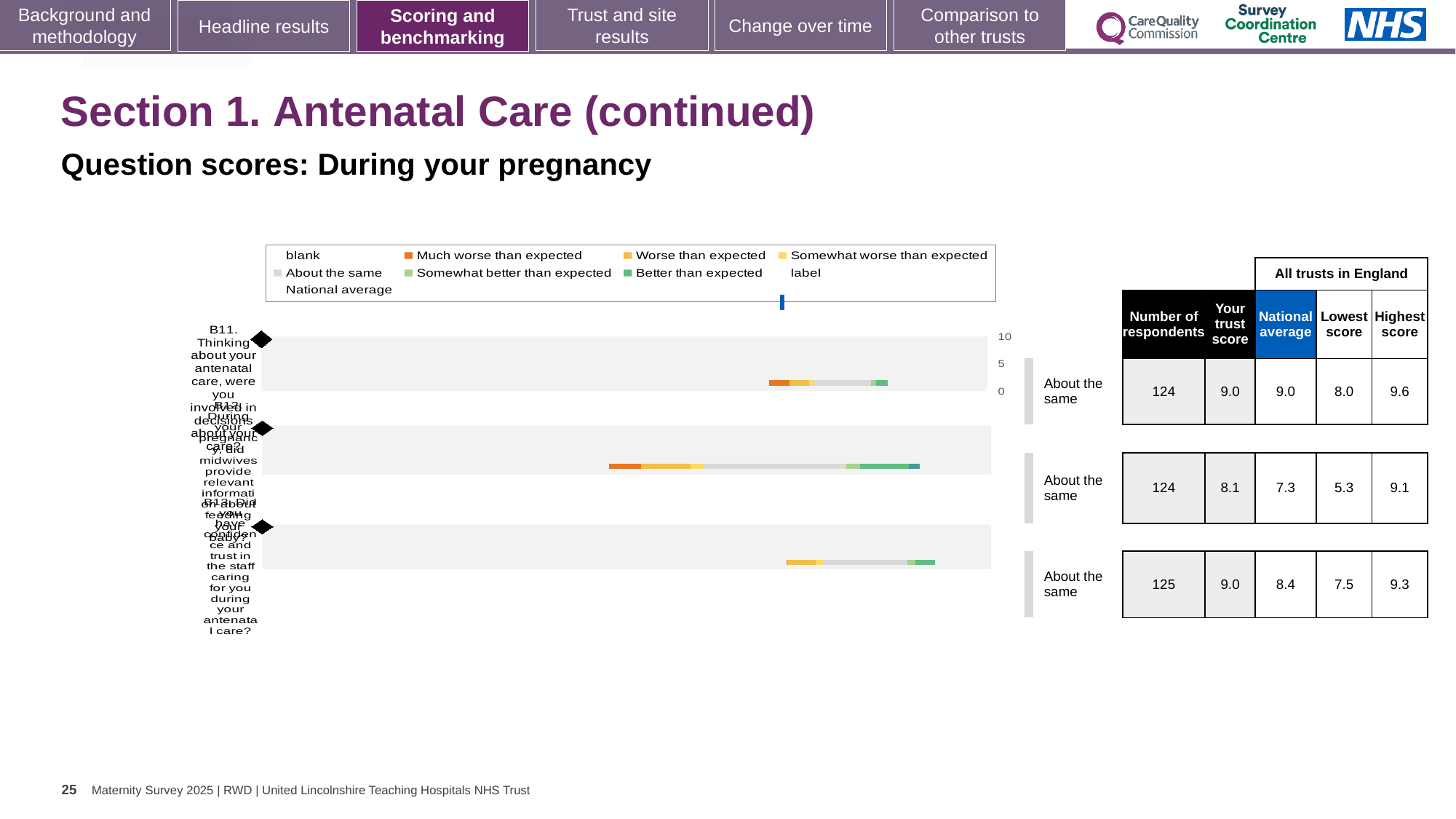
What benchmark label is printed next to the bar for question B13? About the same In the table beside the chart, what is the national average for question B11? 9.0 In the table beside the chart, what is the number of respondents for question B13? 125 What benchmark label is printed next to the bar for question B11? About the same Which legend entry is shown in orange? Much worse than expected In the table beside the chart, which question has the lowest 'Lowest score' value? B12 How many entries does the chart legend list? 9 Which legend entry is shown in dark green? Better than expected In the table beside the chart, what is the difference between the trust score and the national average for question B12? 0.8 What kind of chart is shown on the slide? bar chart How many question bars (categories) are plotted in the chart? 3 In the table beside the chart, what is the trust score for question B12? 8.1